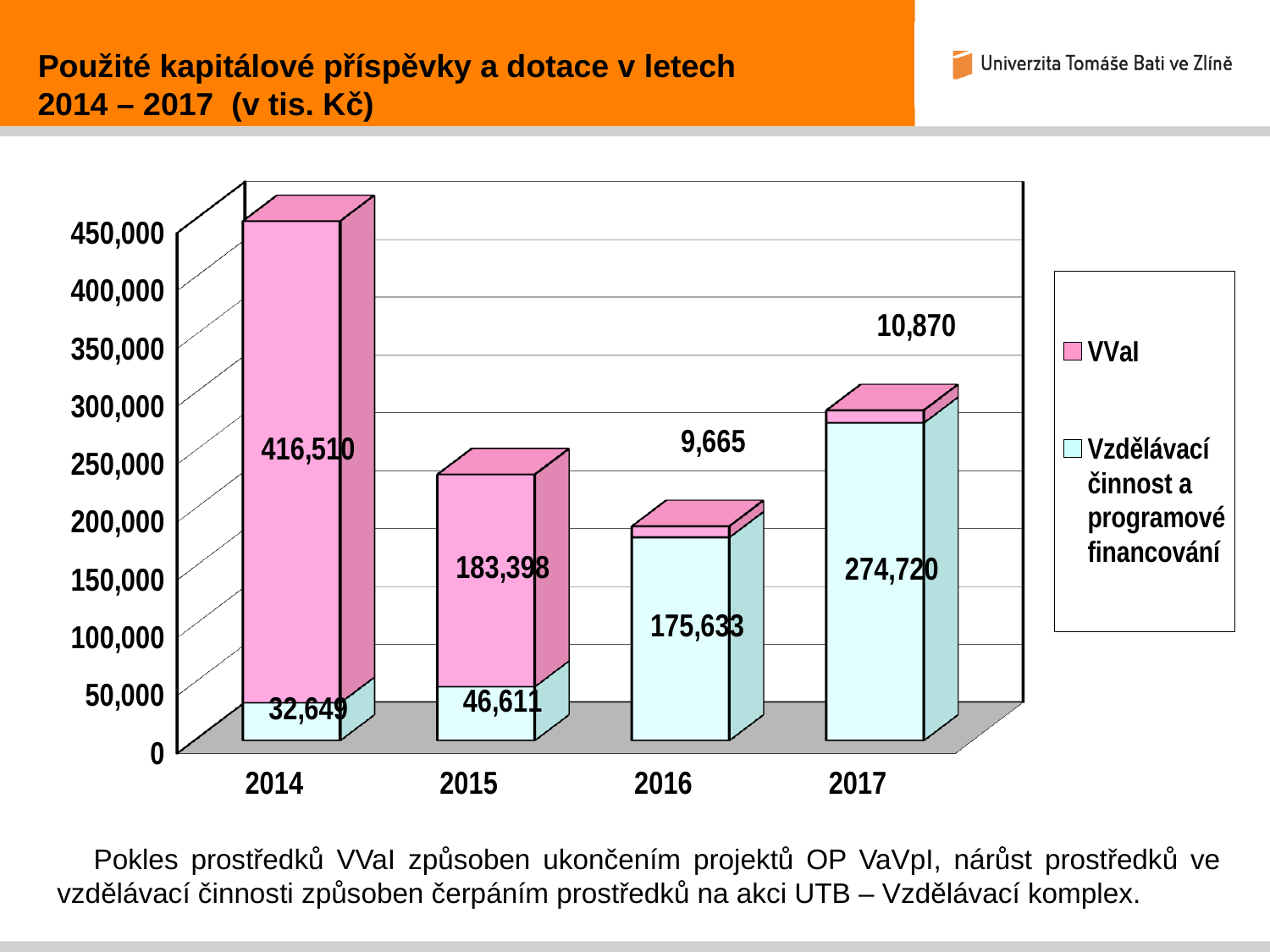
What is the total of the stacked bar for 2017? 285,590 What is the VVaI value for 2014? 416,510 What is the total of the stacked bar for 2014? 449,159 What kind of chart is shown on the slide? Stacked bar chart How many series does the legend list? 2 Which is larger: the VVaI value for 2016 or the VVaI value for 2017? 2017 What is the value for Vzdělávací činnost a programové financování in 2017? 274,720 How many years are shown on the x axis? 4 What is the difference between the VVaI values for 2014 and 2015? 233,112 In which year is the VVaI value highest? 2014 What is the VVaI value for 2016? 9,665 In which year is the value for Vzdělávací činnost a programové financování lowest? 2014